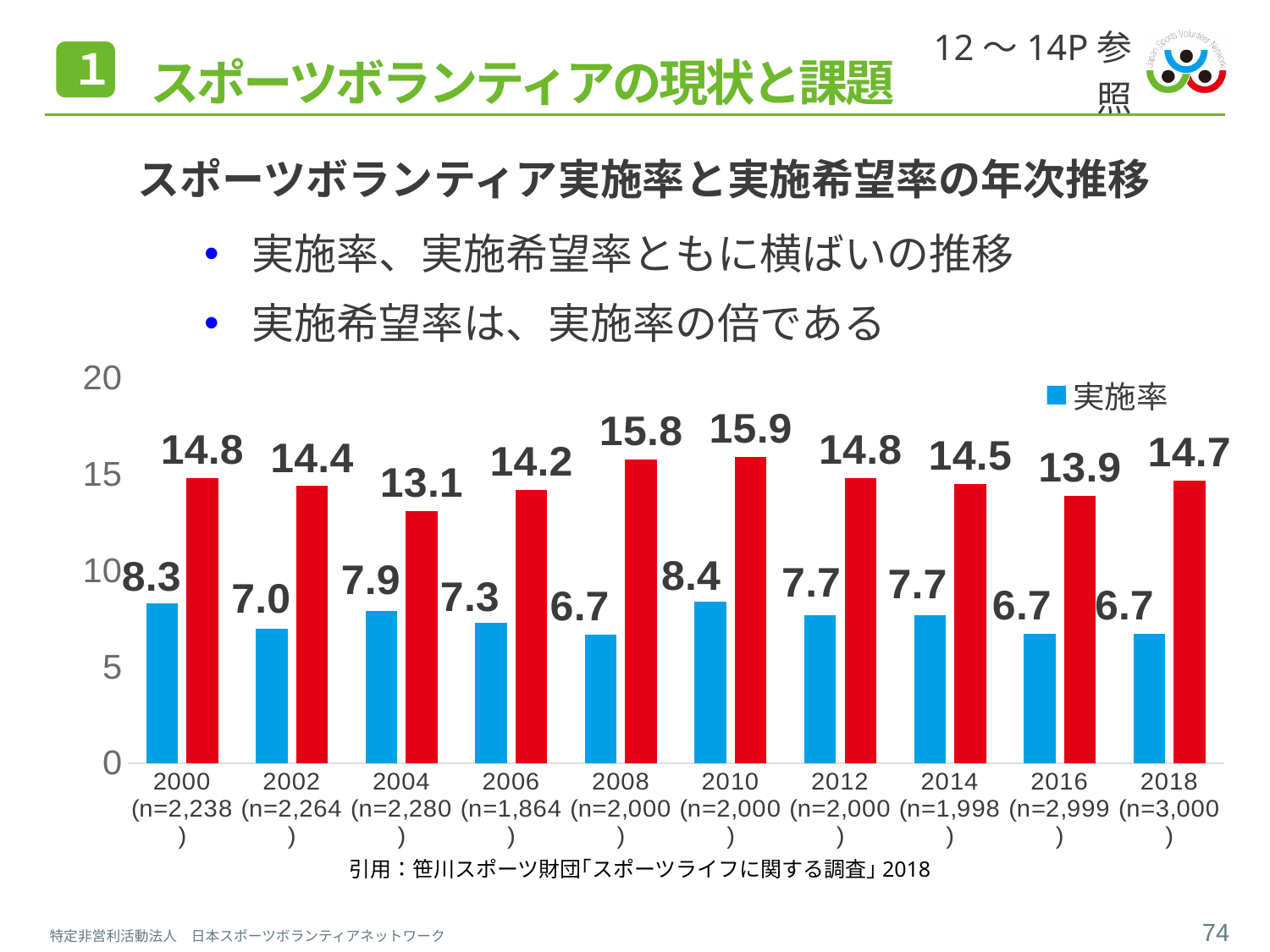
Is the 実施率 value for 2000 greater or less than 10? less What is the value of the red bar for 2004? 13.1 In which year is the 実施率 (blue bar) highest? 2010 In which year is the red bar lowest? 2004 What is the 実施率 value for 2010? 8.4 How many years are shown on the x axis of the chart? 10 What is the difference between the red bar and the 実施率 bar for 2000? 6.5 What is the difference between the red bar and the blue bar for 2010? 7.5 What colour are the 実施率 bars in the chart? blue What is the 実施率 value for 2018? 6.7 What kind of chart is shown on the slide? bar chart Which year has the larger 実施率 value, 2008 or 2010? 2010